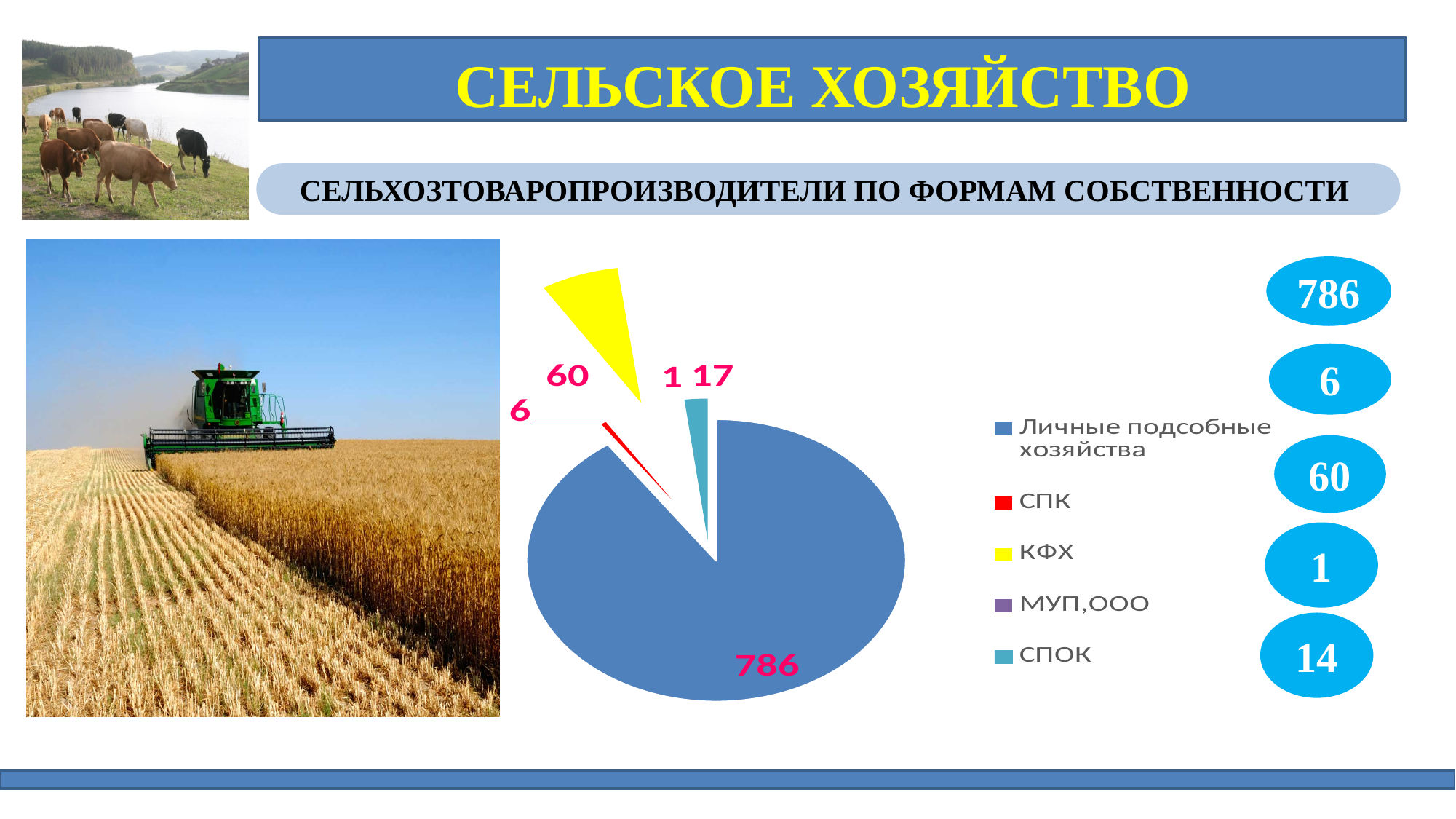
How many entries does the legend of the pie chart list? 5 Which category has the largest slice in the pie chart? Личные подсобные хозяйства Which category has the smallest slice in the pie chart? МУП,ООО What is the value for СПК in the pie chart? 6 What colour is the КФХ slice in the pie chart? yellow What kind of chart is shown on the slide? pie chart What is the value for КФХ in the pie chart? 60 What is the value for Личные подсобные хозяйства in the pie chart? 786 What is the value for МУП,ООО in the pie chart? 1 Which is larger, the value for КФХ or the value for СПК? КФХ What is the difference between the values for Личные подсобные хозяйства and КФХ? 726 What is the difference between the values for КФХ and СПК? 54